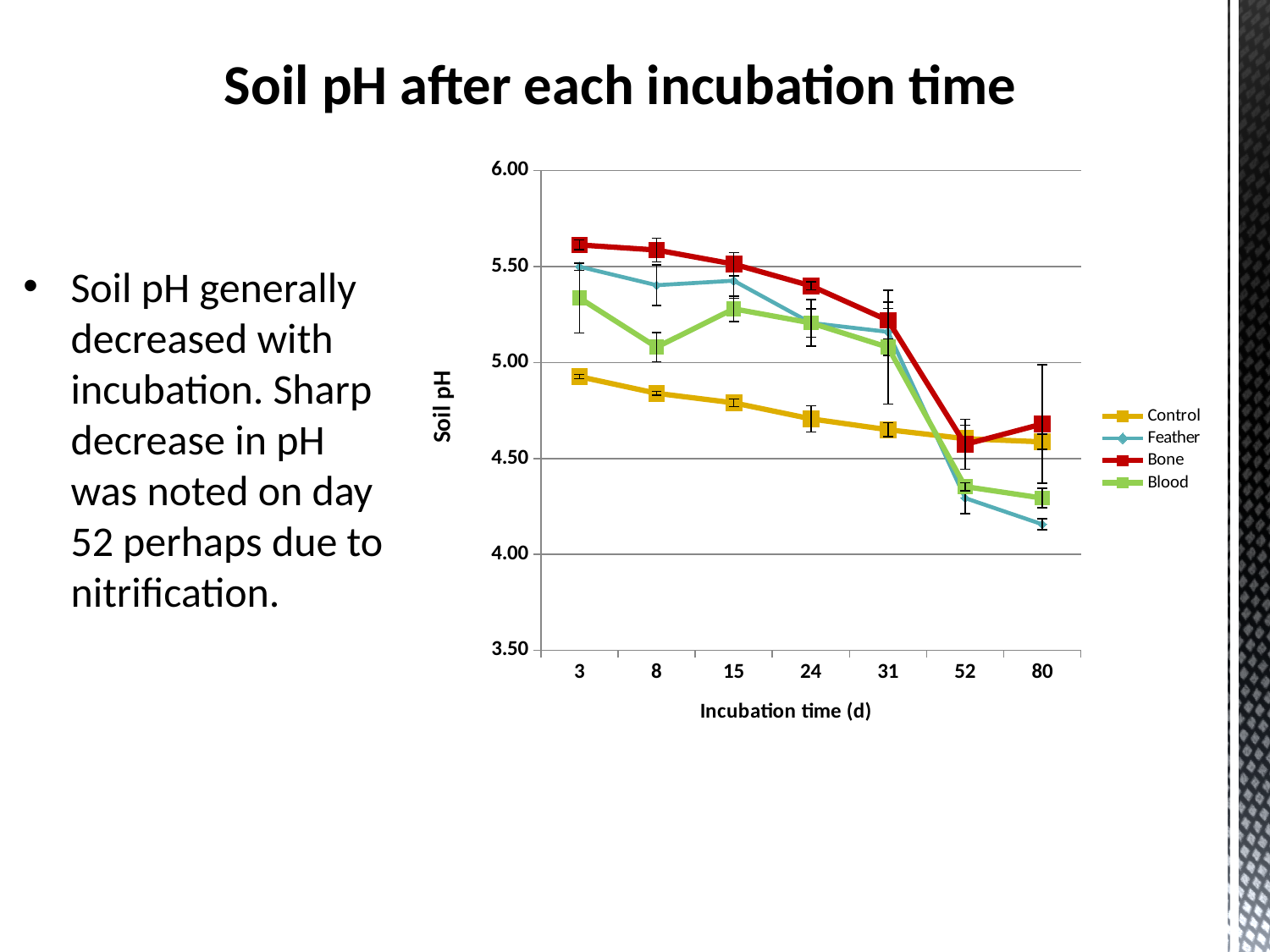
Which series has the highest soil pH at incubation time 3 d? Bone Which series has the lowest soil pH at incubation time 3 d? Control How many series does the legend list? 4 Is the soil pH for Control at 3 d greater or less than 5.00? less Is the soil pH for Blood at 52 d greater or less than 4.50? less At incubation time 8 d, which has the higher soil pH, Feather or Blood? Feather How many incubation time points are plotted on the x axis? 7 Is the soil pH for Bone at 3 d greater or less than 5.50? greater Does the soil pH for Control rise or fall as incubation time increases? fall What is the label of the y axis? Soil pH Which series has the lowest soil pH at incubation time 80 d? Feather What kind of chart is shown on the slide? line chart